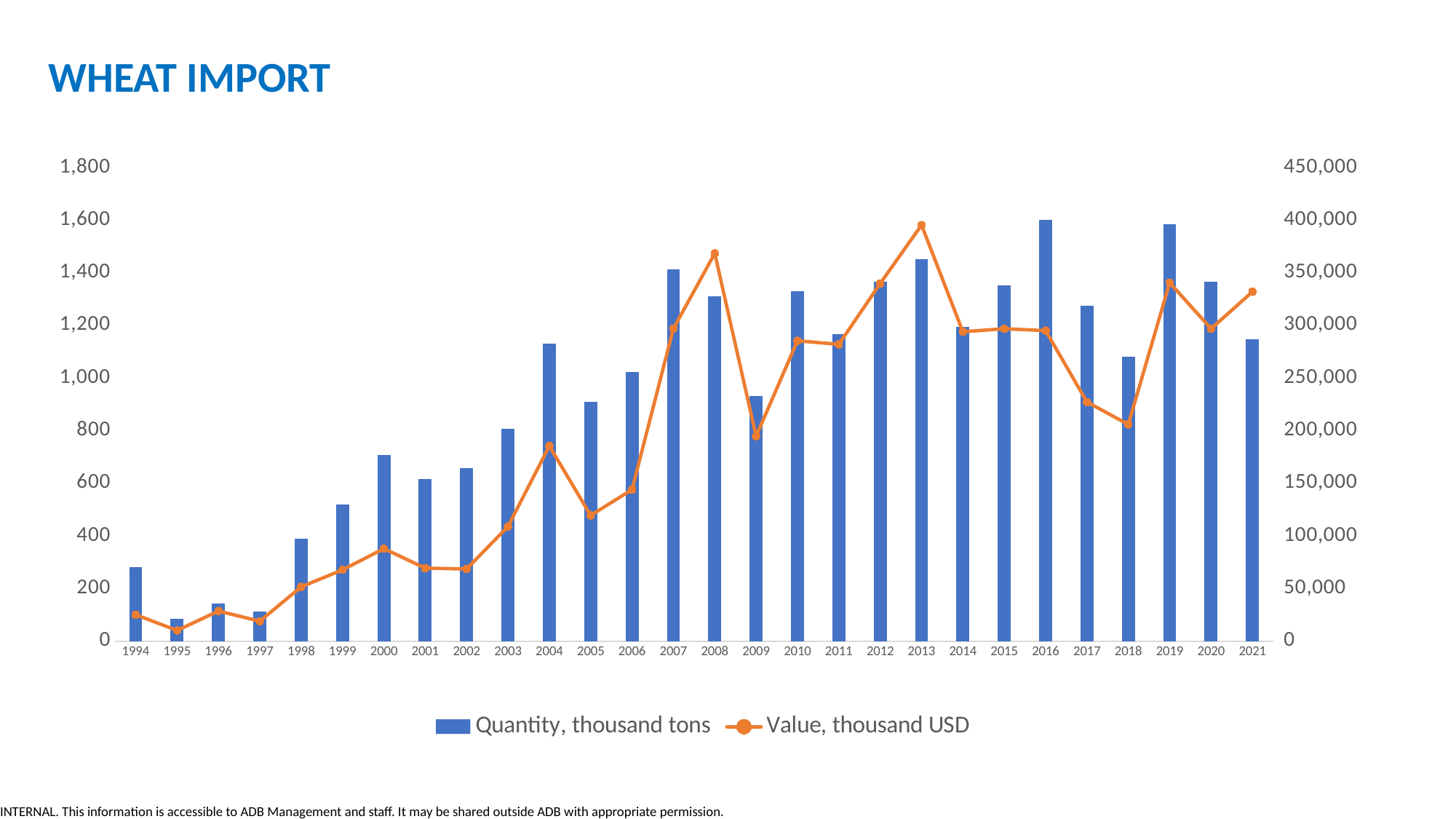
Is the Quantity, thousand tons for 2004 greater or less than 1,000? greater What kind of chart is shown on the slide? Combined bar and line chart How many years are shown on the x axis? 28 How many series does the legend list? 2 Is the Value, thousand USD for 2009 greater or less than 250,000? less Which year has the highest Value, thousand USD? 2013 Which year has the lowest Quantity, thousand tons? 1995 Does the Value, thousand USD line generally rise or fall from 2013 to 2018? fall Which year has the lowest Value, thousand USD? 1995 Is the Quantity, thousand tons for 2021 greater or less than 1,200? less Which year has the larger Quantity, thousand tons: 2007 or 2008? 2007 Which year has the larger Quantity, thousand tons: 2017 or 2018? 2017